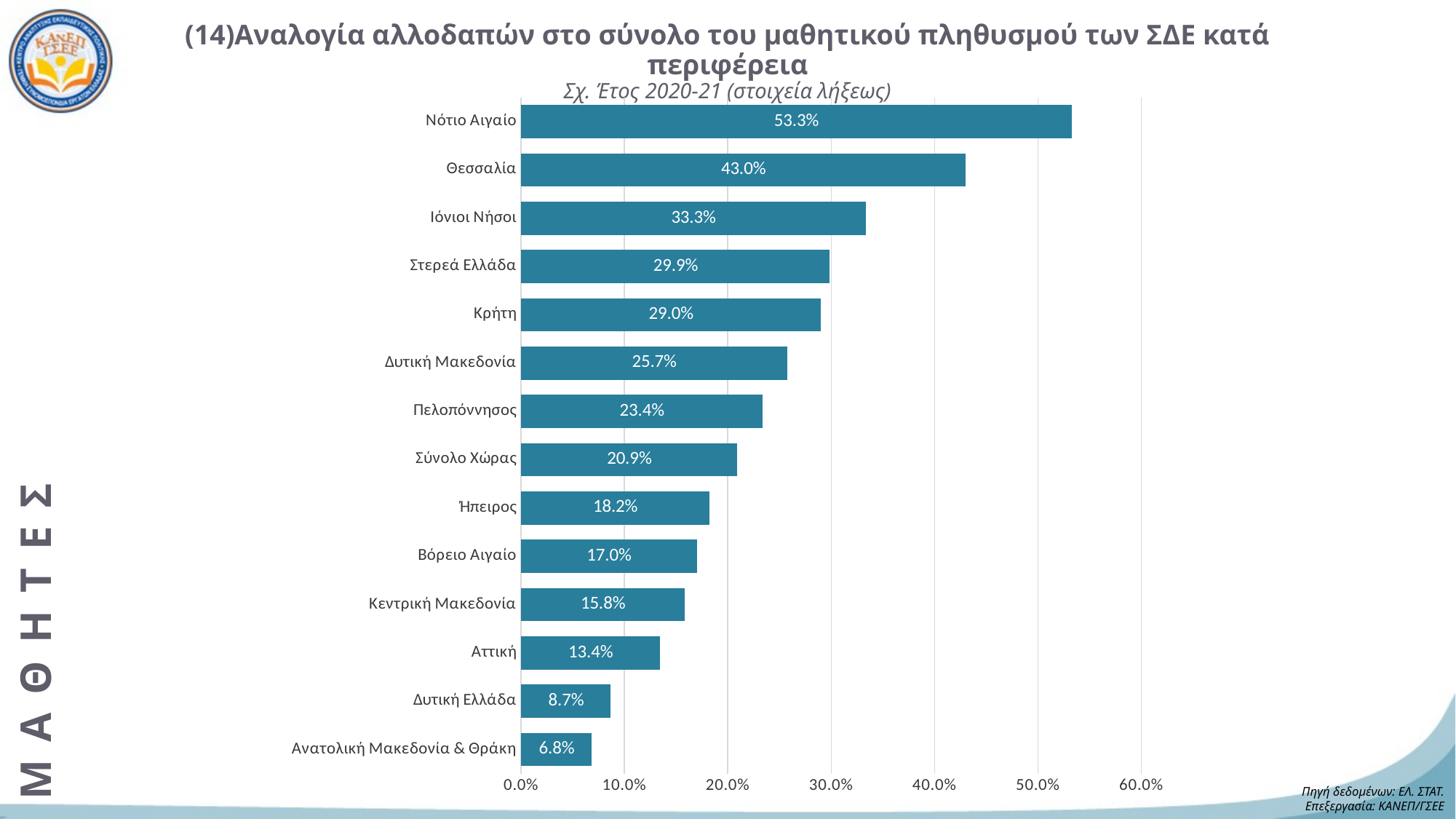
Is the value for Ιόνιοι Νήσοι greater or less than 30.0%? greater What is the value for Σύνολο Χώρας? 20.9% Which region has the highest value? Νότιο Αιγαίο How many categories are shown in the chart? 14 What is the value for Αττική? 13.4% What school year does the chart subtitle refer to? 2020-21 What is the difference between the values for Νότιο Αιγαίο and Θεσσαλία? 10.3% What kind of chart is shown on the slide? bar chart What is the difference between the values for Κρήτη and Δυτική Ελλάδα? 20.3% Which category has the lowest value? Ανατολική Μακεδονία & Θράκη What is the value for Θεσσαλία? 43.0% Which is larger, the value for Ήπειρος or the value for Βόρειο Αιγαίο? Ήπειρος